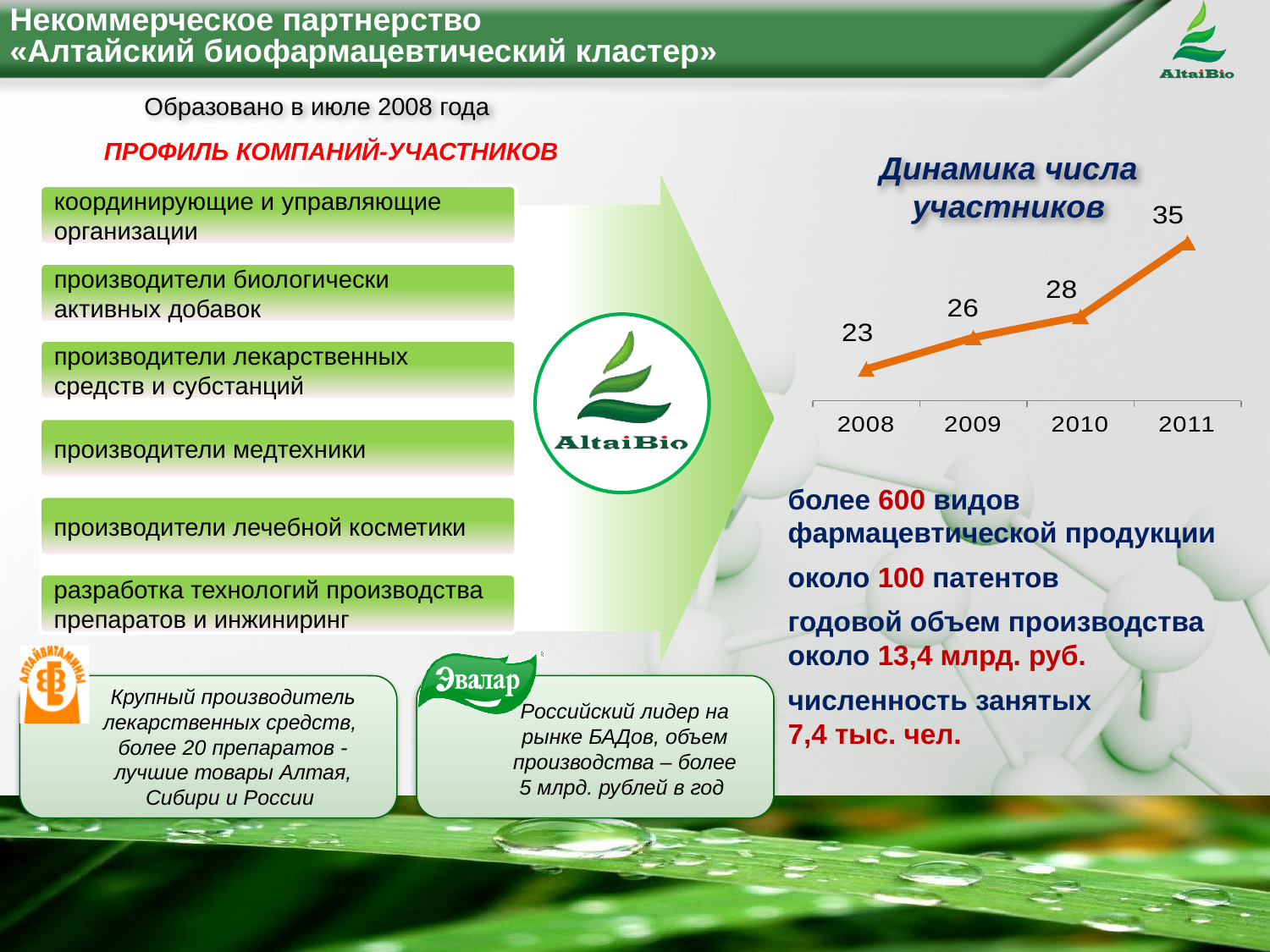
How many years are plotted on the 'Динамика числа участников' chart? 4 Which year has the lowest number of participants on the 'Динамика числа участников' chart? 2008 What is the number of participants in 2010 on the 'Динамика числа участников' chart? 28 Which year has the highest number of participants on the 'Динамика числа участников' chart? 2011 What is the number of participants in 2009 on the 'Динамика числа участников' chart? 26 What is the number of participants in 2011 on the 'Динамика числа участников' chart? 35 Which year has more participants on the 'Динамика числа участников' chart, 2009 or 2010? 2010 Does the number of participants rise or fall from 2008 to 2011 on the 'Динамика числа участников' chart? rise What is the difference in participants between 2010 and 2011 on the 'Динамика числа участников' chart? 7 What type of chart is used to show 'Динамика числа участников'? line chart What is the number of participants in 2008 on the 'Динамика числа участников' chart? 23 By how much did the number of participants increase from 2008 to 2011 on the 'Динамика числа участников' chart? 12